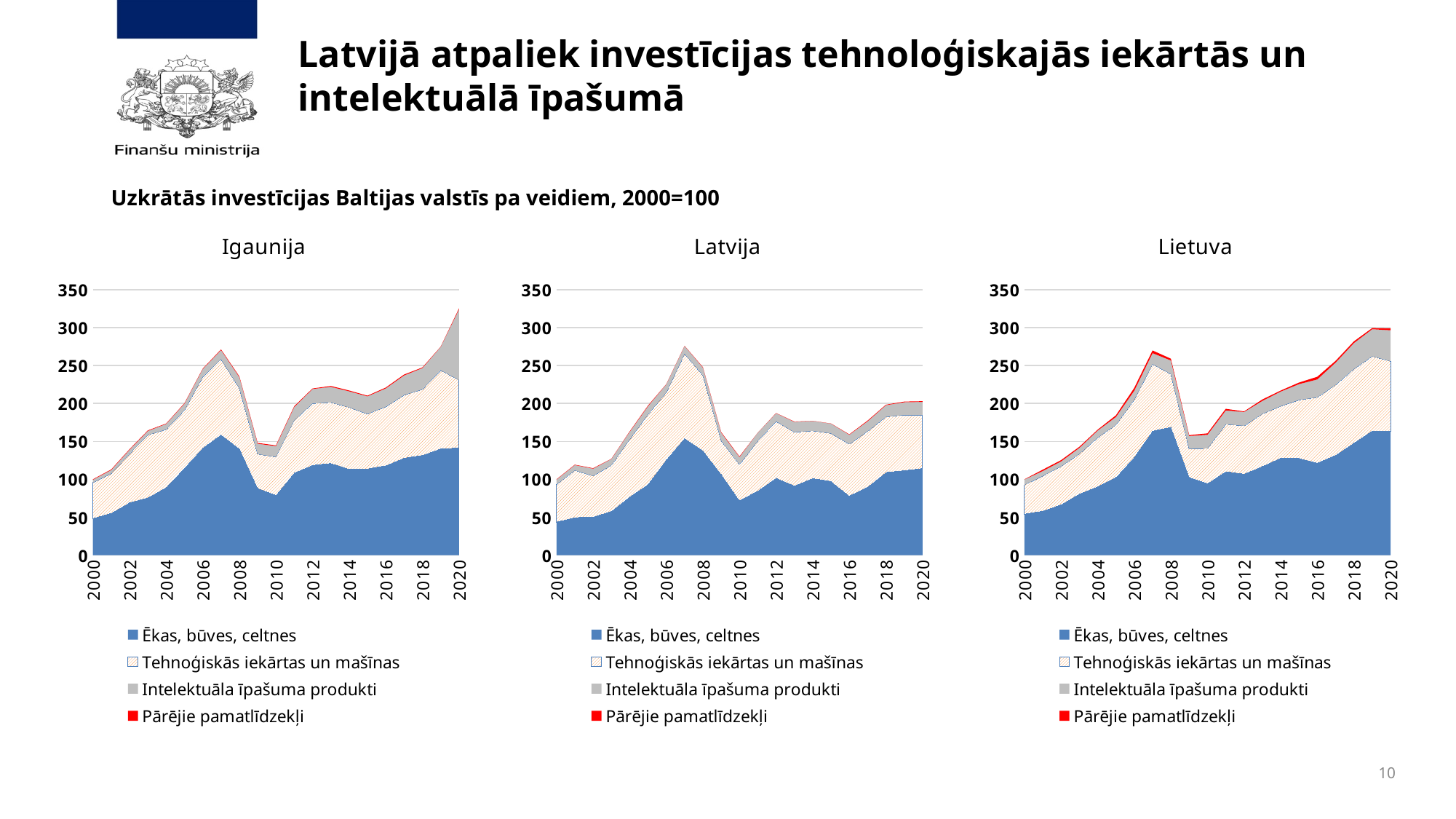
Which of the three charts shows the highest total value in 2020? Igaunija What colour represents Pārējie pamatlīdzekļi in the legends? red How many series does the legend of the Latvija chart list? 4 In the Latvija chart, does the total value rise or fall from 2007 to 2010? fall How many charts are shown on the slide? 3 In the Lietuva chart, is the total value for 2007 greater or less than 250? greater In the Latvija chart, is the total value for 2010 greater or less than 150? less In the Latvija chart, is the value of Ēkas, būves, celtnes in 2020 greater or less than 100? greater Which of the three charts shows the lowest total value in 2020? Latvija What kind of chart is the Igaunija chart? stacked area chart